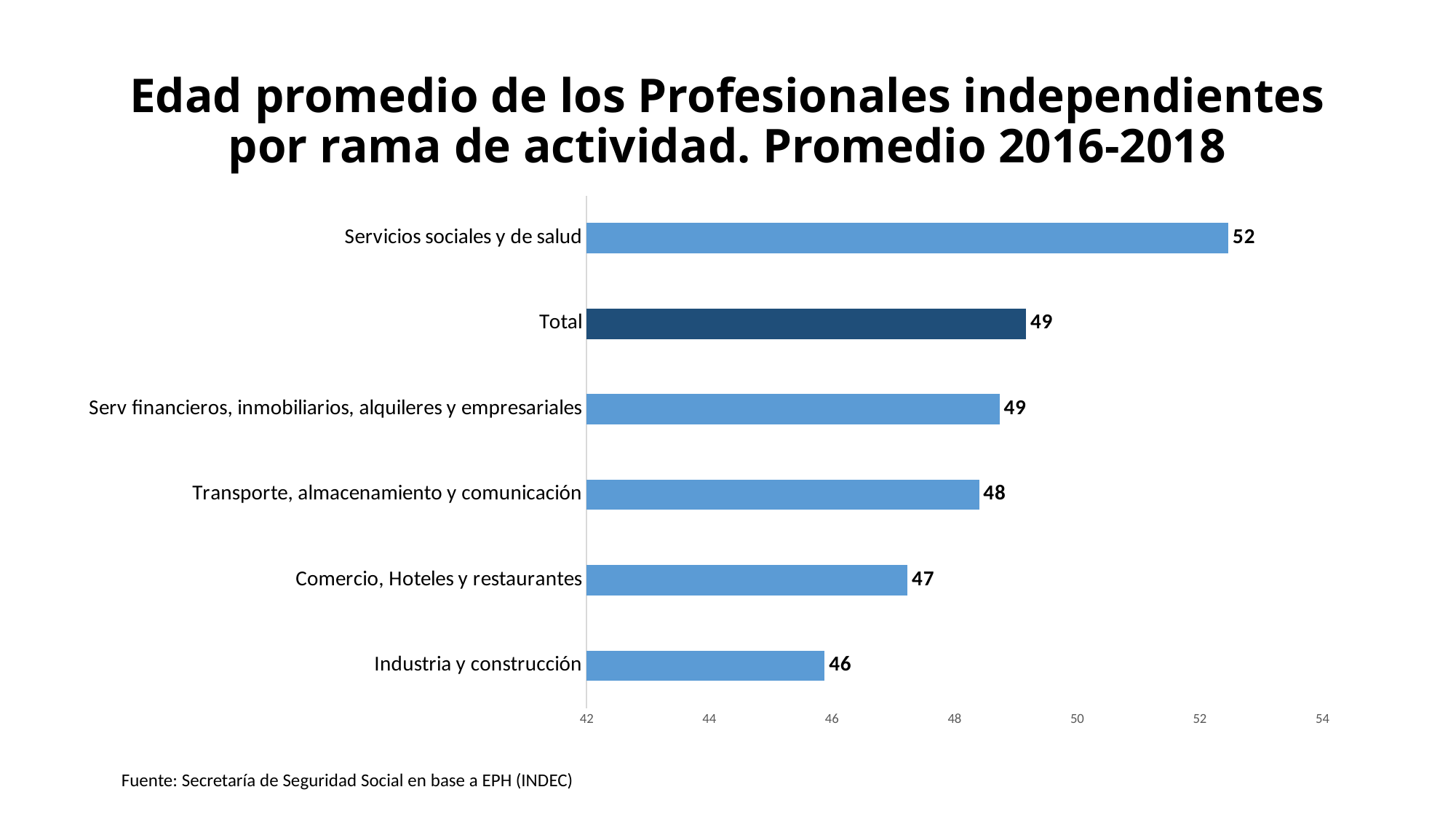
What is the value for the Total bar? 49 What is the average age shown for Servicios sociales y de salud? 52 What is the value for Transporte, almacenamiento y comunicación? 48 Which is larger, the value for Comercio, Hoteles y restaurantes or the value for Transporte, almacenamiento y comunicación? Transporte, almacenamiento y comunicación What kind of chart is shown on the slide? bar chart Which bar is drawn in a darker blue than the others? Total Is the value for Comercio, Hoteles y restaurantes greater or less than 50? less How many bars are shown in the chart? 6 Which category has the highest average age? Servicios sociales y de salud What is the difference between the values for Servicios sociales y de salud and Industria y construcción? 6 What is the value for Industria y construcción? 46 Which category has the lowest average age? Industria y construcción